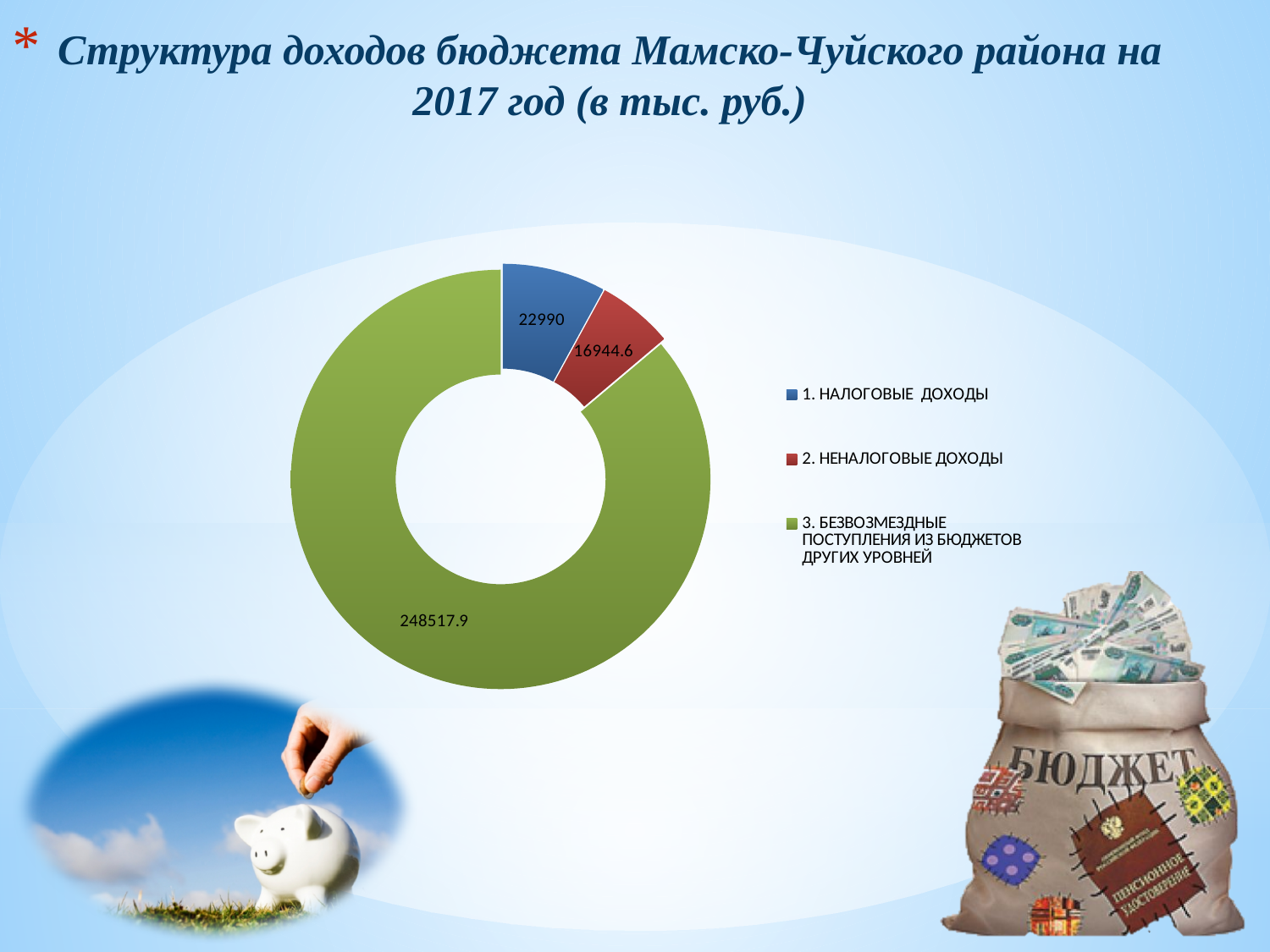
How many categories does the chart show? 3 What is the value for 3. БЕЗВОЗМЕЗДНЫЕ ПОСТУПЛЕНИЯ ИЗ БЮДЖЕТОВ ДРУГИХ УРОВНЕЙ? 248517.9 What is the difference between the values for 1. НАЛОГОВЫЕ ДОХОДЫ and 2. НЕНАЛОГОВЫЕ ДОХОДЫ? 6045.4 Which category has the largest value? 3. БЕЗВОЗМЕЗДНЫЕ ПОСТУПЛЕНИЯ ИЗ БЮДЖЕТОВ ДРУГИХ УРОВНЕЙ Which is larger, the value for 1. НАЛОГОВЫЕ ДОХОДЫ or 2. НЕНАЛОГОВЫЕ ДОХОДЫ? 1. НАЛОГОВЫЕ ДОХОДЫ What colour is the slice for 3. БЕЗВОЗМЕЗДНЫЕ ПОСТУПЛЕНИЯ ИЗ БЮДЖЕТОВ ДРУГИХ УРОВНЕЙ? green What is the value for 2. НЕНАЛОГОВЫЕ ДОХОДЫ? 16944.6 How many entries does the legend list? 3 What is the value for 1. НАЛОГОВЫЕ ДОХОДЫ? 22990 What is the total of all three values shown on the chart? 288452.5 What kind of chart is shown on the slide? doughnut chart Which category has the smallest value? 2. НЕНАЛОГОВЫЕ ДОХОДЫ